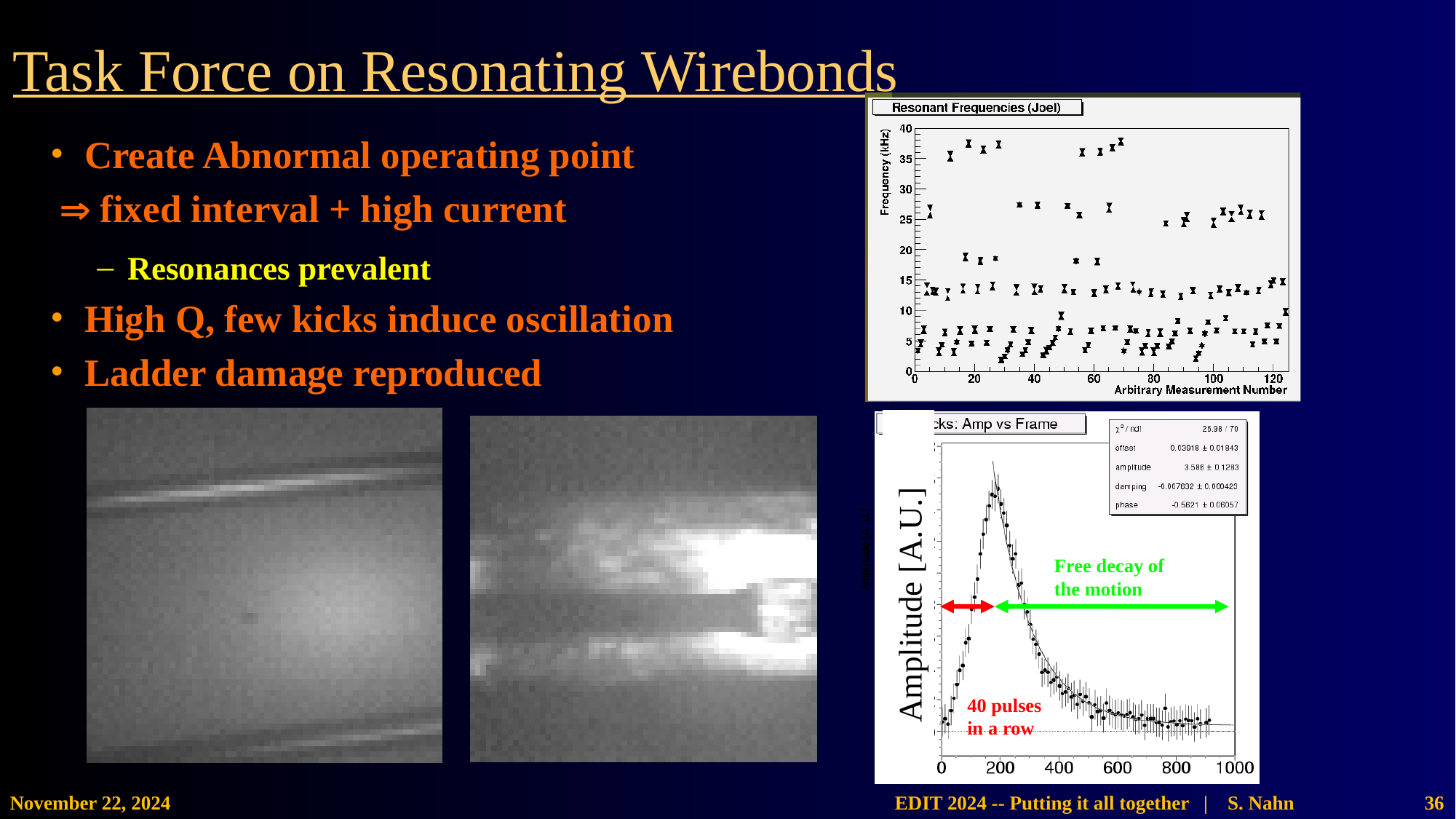
In the 'Kicks: Amp vs Frame' chart, what is the fitted damping value listed in the statistics box? -0.007632 ± 0.000423 In the 'Kicks: Amp vs Frame' chart, what is the fitted amplitude value listed in the statistics box? 3.586 ± 0.1283 In the 'Kicks: Amp vs Frame' chart, what is the chi-squared per degrees of freedom listed in the statistics box? 26.98 / 70 What kind of chart is the 'Resonant Frequencies (Joel)' chart? scatter plot In the 'Resonant Frequencies (Joel)' chart, is the lowest plotted frequency greater or less than 5 kHz? less In the 'Resonant Frequencies (Joel)' chart, is the highest plotted frequency greater or less than 35 kHz? greater In the 'Kicks: Amp vs Frame' chart, does the amplitude rise or fall along the x axis after its peak? fall In the 'Resonant Frequencies (Joel)' chart, what is the label of the y axis? Frequency (kHz) In the 'Kicks: Amp vs Frame' chart, what is the fitted phase value listed in the statistics box? -0.5621 ± 0.06057 In the 'Resonant Frequencies (Joel)' chart, what is the maximum value shown on the y axis? 40 In the 'Resonant Frequencies (Joel)' chart, what is the label of the x axis? Arbitrary Measurement Number